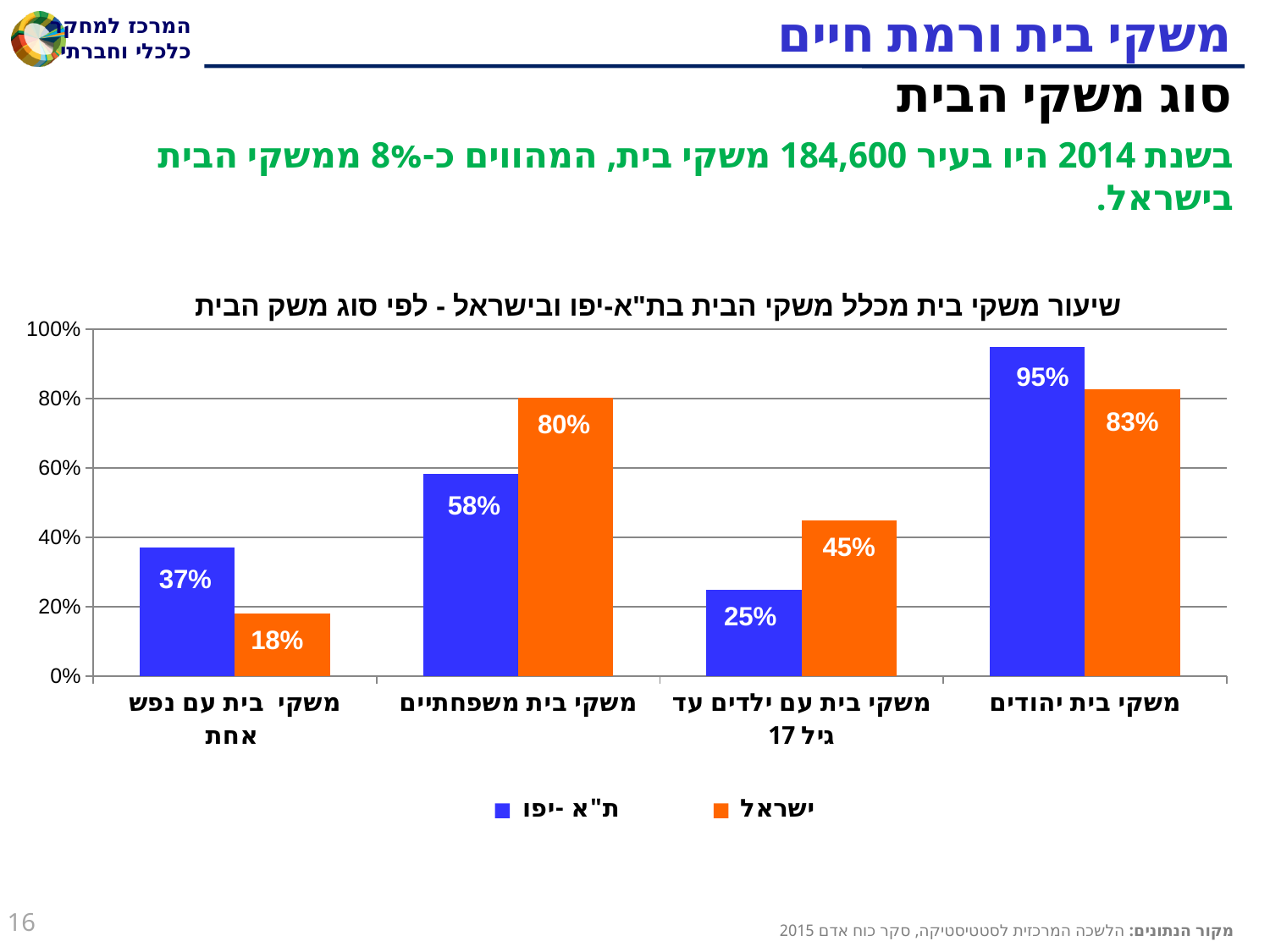
What is the value for ת"א -יפו in the category משקי בית עם ילדים עד גיל 17? 25% What is the value for ישראל in the category משקי בית יהודים? 83% How many categories are shown on the x axis of the chart? 4 Which category has the highest value for the ת"א -יפו series? משקי בית יהודים What is the difference between the ישראל and ת"א -יפו values in the category משקי בית משפחתיים? 22% What is the value for ישראל in the category משקי בית משפחתיים? 80% What is the value for ת"א -יפו in the category משקי בית עם נפש אחת? 37% Which colour represents the ישראל series in the chart? orange In the category משקי בית עם ילדים עד גיל 17, which series has the larger value, ת"א -יפו or ישראל? ישראל How many series does the chart legend list? 2 Which category has the lowest value for the ישראל series? משקי בית עם נפש אחת What kind of chart is shown on the slide? bar chart